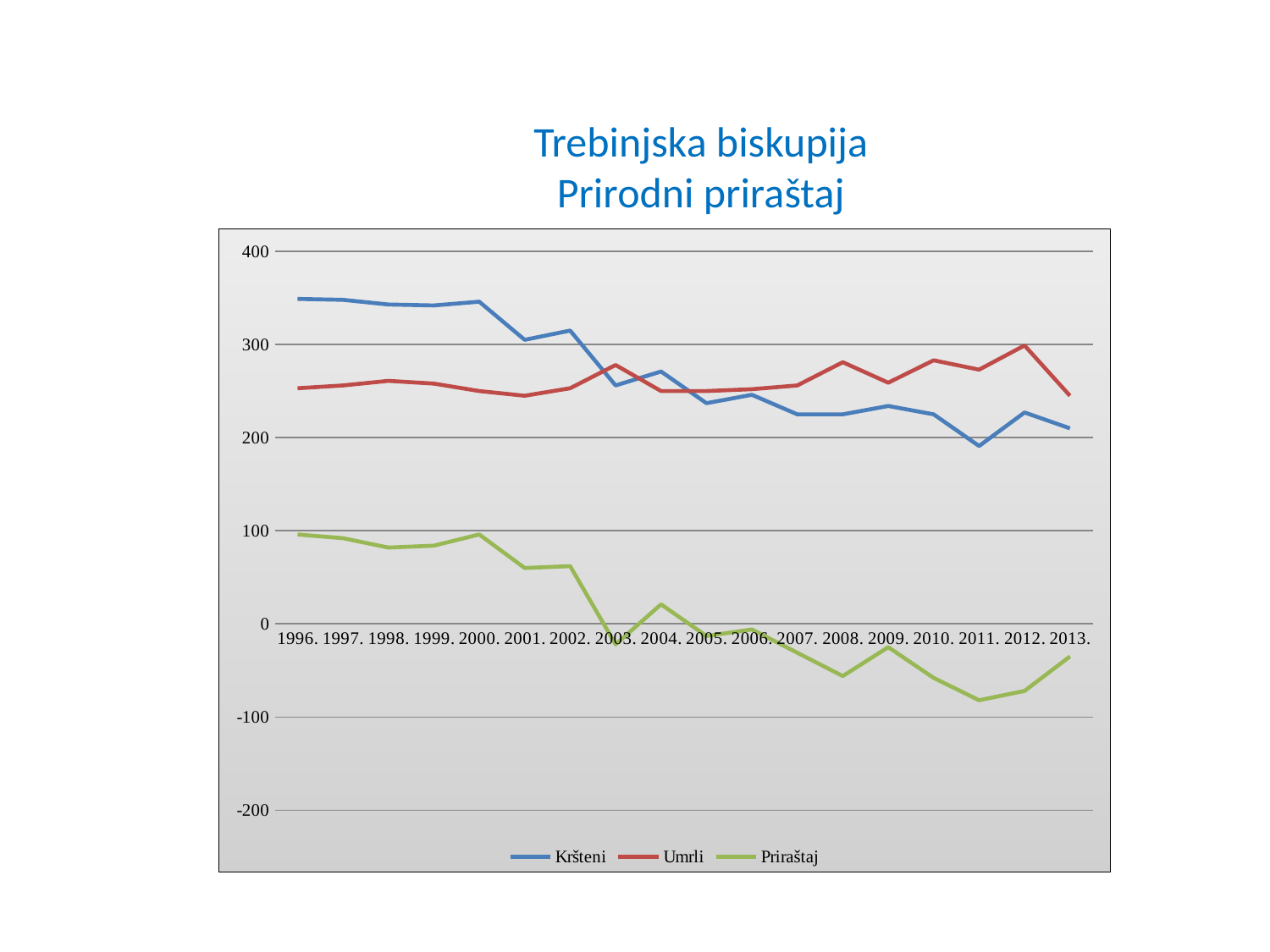
Which series is drawn in green? Priraštaj Does the Kršteni series generally rise or fall from 1996 to 2013? fall In which year is the Kršteni value lowest? 2011. In which year is the Umrli value highest? 2012. Is the Priraštaj value for 2011 greater or less than 0? less Which is larger in 2012, Kršteni or Umrli? Umrli How many series does the legend list? 3 Which is larger in 1996, Kršteni or Umrli? Kršteni How many years are plotted along the x axis? 18 Is the Kršteni value for 1996 greater or less than 300? greater What kind of chart is shown on the slide? line chart In which year is the Priraštaj value lowest? 2011.